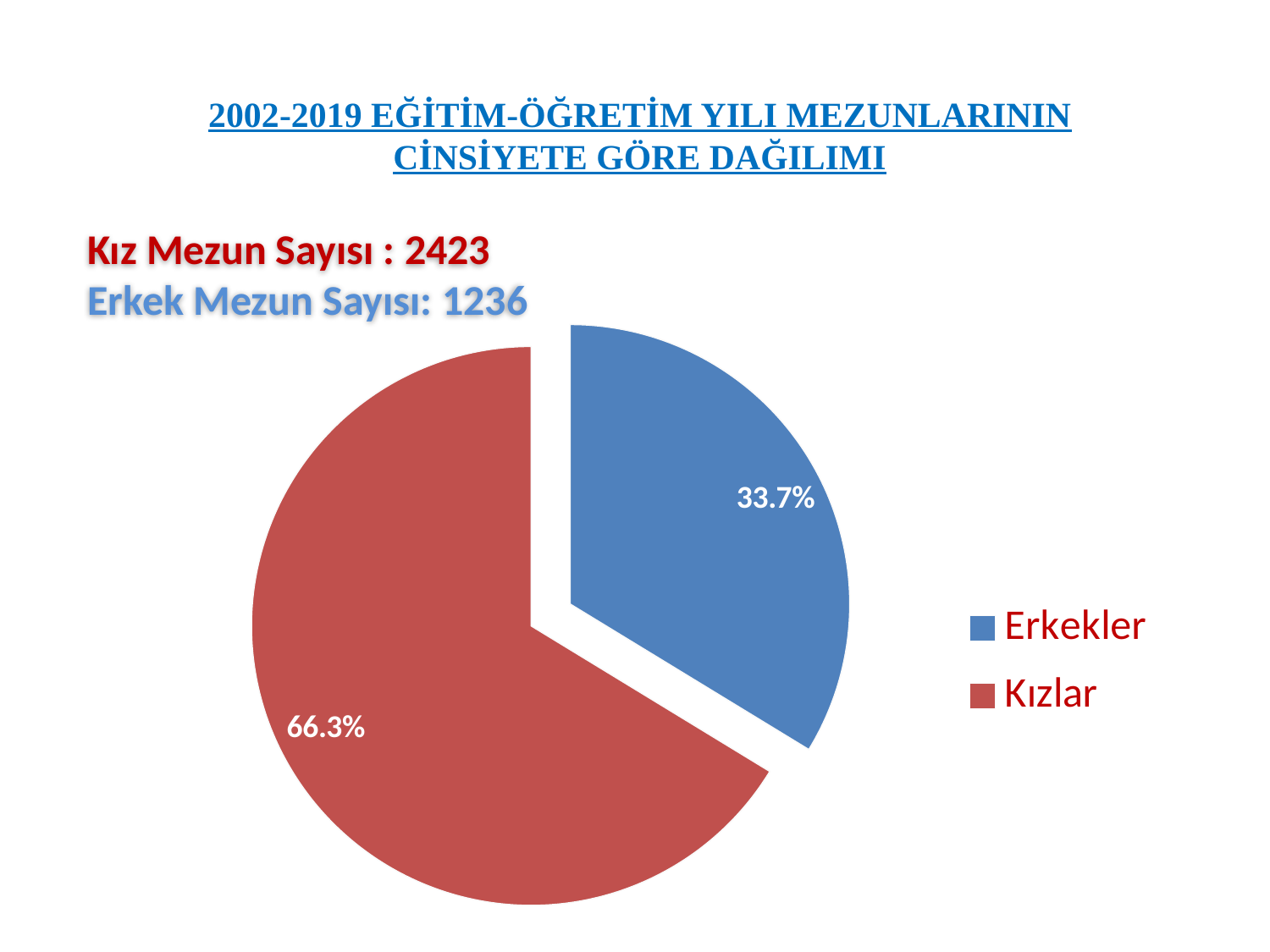
Which slice of the pie is the largest? Kızlar What share of the pie does the Erkekler slice represent? 33.7% What colour is the Erkekler slice? blue What kind of chart is shown on the slide? pie chart What share of the pie does the Kızlar slice represent? 66.3% Which slice of the pie is the smallest? Erkekler What is the difference in percentage points between the Kızlar and Erkekler slices? 32.6 Which slice is larger, Erkekler or Kızlar? Kızlar How many slices does the pie chart have? 2 What colour is the Kızlar slice? red Is the share for Erkekler greater or less than 50%? less How many entries does the legend list? 2